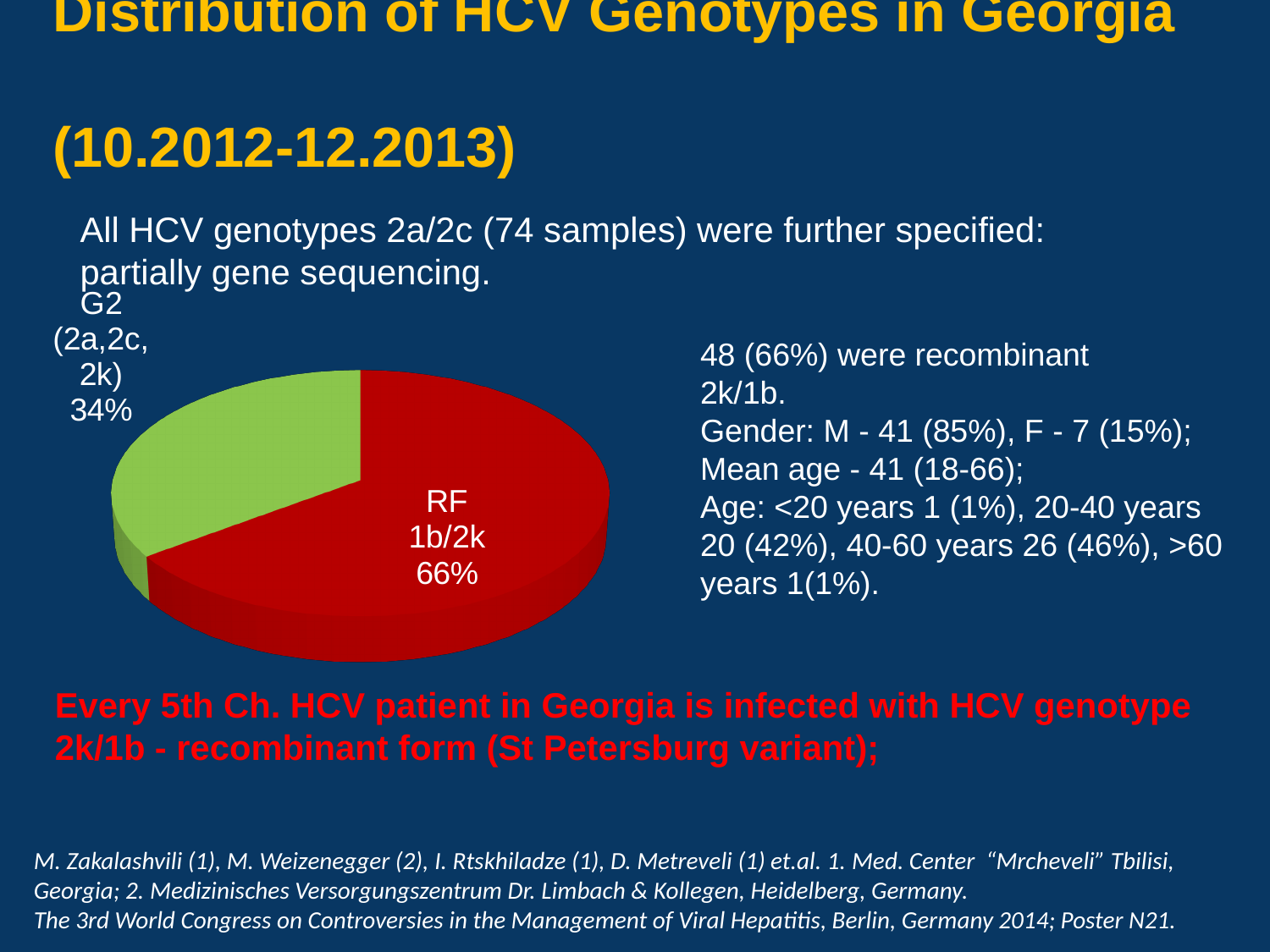
Which slice of the pie is the smallest? G2 (2a,2c, 2k) What colour is the RF 1b/2k slice of the pie? red What percentage of the pie is labelled RF 1b/2k? 66% Which slice is larger, RF 1b/2k or G2 (2a,2c, 2k)? RF 1b/2k Which slice of the pie is the largest? RF 1b/2k What kind of chart is shown on the slide? pie chart What colour is the G2 (2a,2c, 2k) slice of the pie? green What share of the pie does the RF 1b/2k slice represent? 66% How many slices does the pie chart have? 2 What percentage of the pie is labelled G2 (2a,2c, 2k)? 34% What is the difference in percentage points between the RF 1b/2k slice and the G2 (2a,2c, 2k) slice? 32